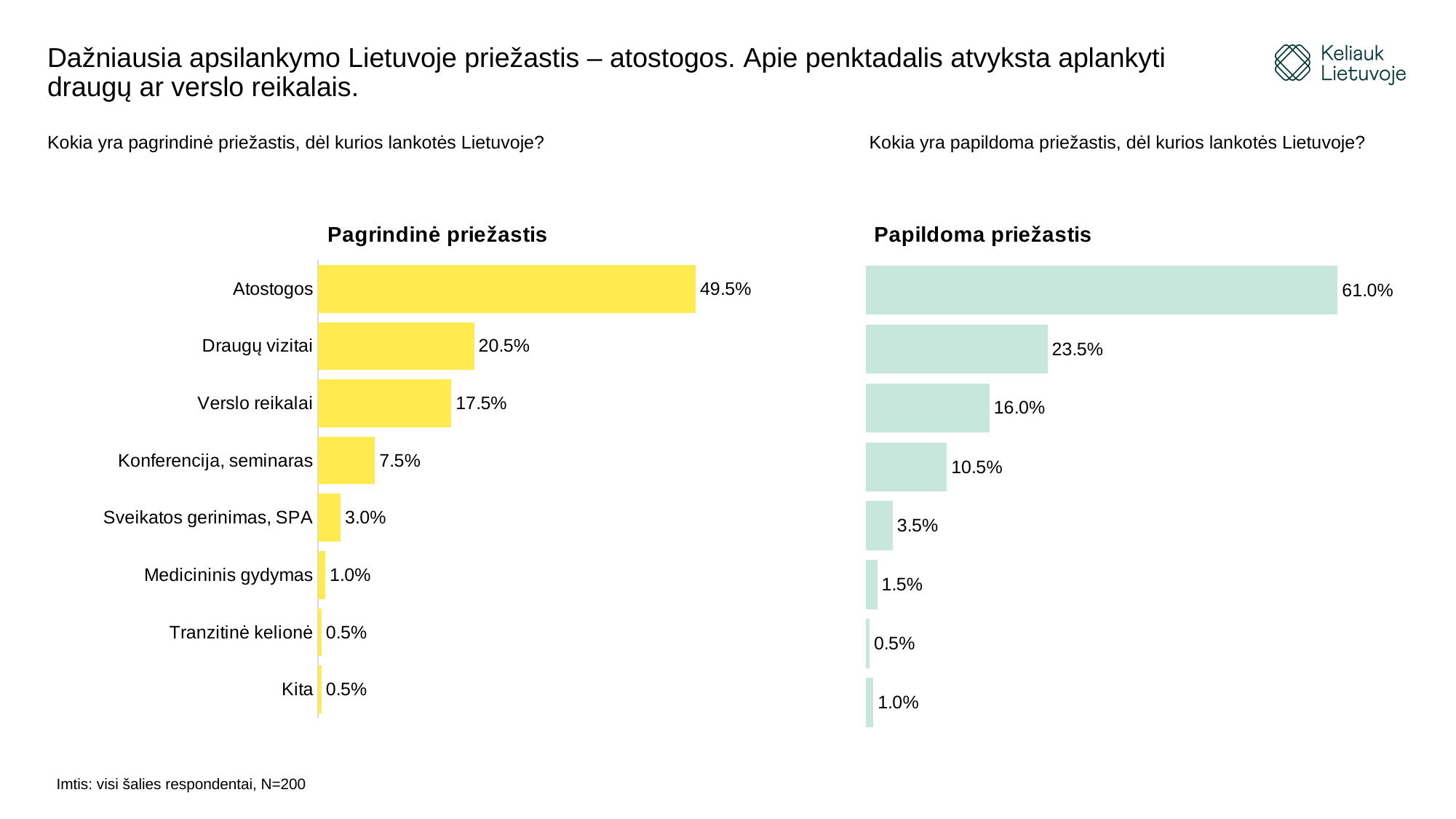
What type of chart is 'Papildoma priežastis'? Bar chart In the 'Pagrindinė priežastis' chart, what is the value for Verslo reikalai? 17.5% In the 'Pagrindinė priežastis' chart, which category has the lowest value among the top five categories? Sveikatos gerinimas, SPA In the 'Papildoma priežastis' chart, what is the difference between the top bar (61.0%) and the second bar (23.5%)? 37.5% In the 'Pagrindinė priežastis' chart, what is the value for Atostogos? 49.5% How many categories are shown in the 'Pagrindinė priežastis' chart? 8 In the 'Papildoma priežastis' chart, what is the value of the top bar? 61.0% In the 'Pagrindinė priežastis' chart, which is larger: Konferencija, seminaras or Sveikatos gerinimas, SPA? Konferencija, seminaras In the 'Pagrindinė priežastis' chart, what is the difference between Draugų vizitai and Verslo reikalai? 3.0% In the 'Papildoma priežastis' chart, what is the value of the bar in the row for Konferencija, seminaras? 10.5% In the 'Pagrindinė priežastis' chart, which category has the highest value? Atostogos What colour are the bars in the 'Pagrindinė priežastis' chart? Yellow